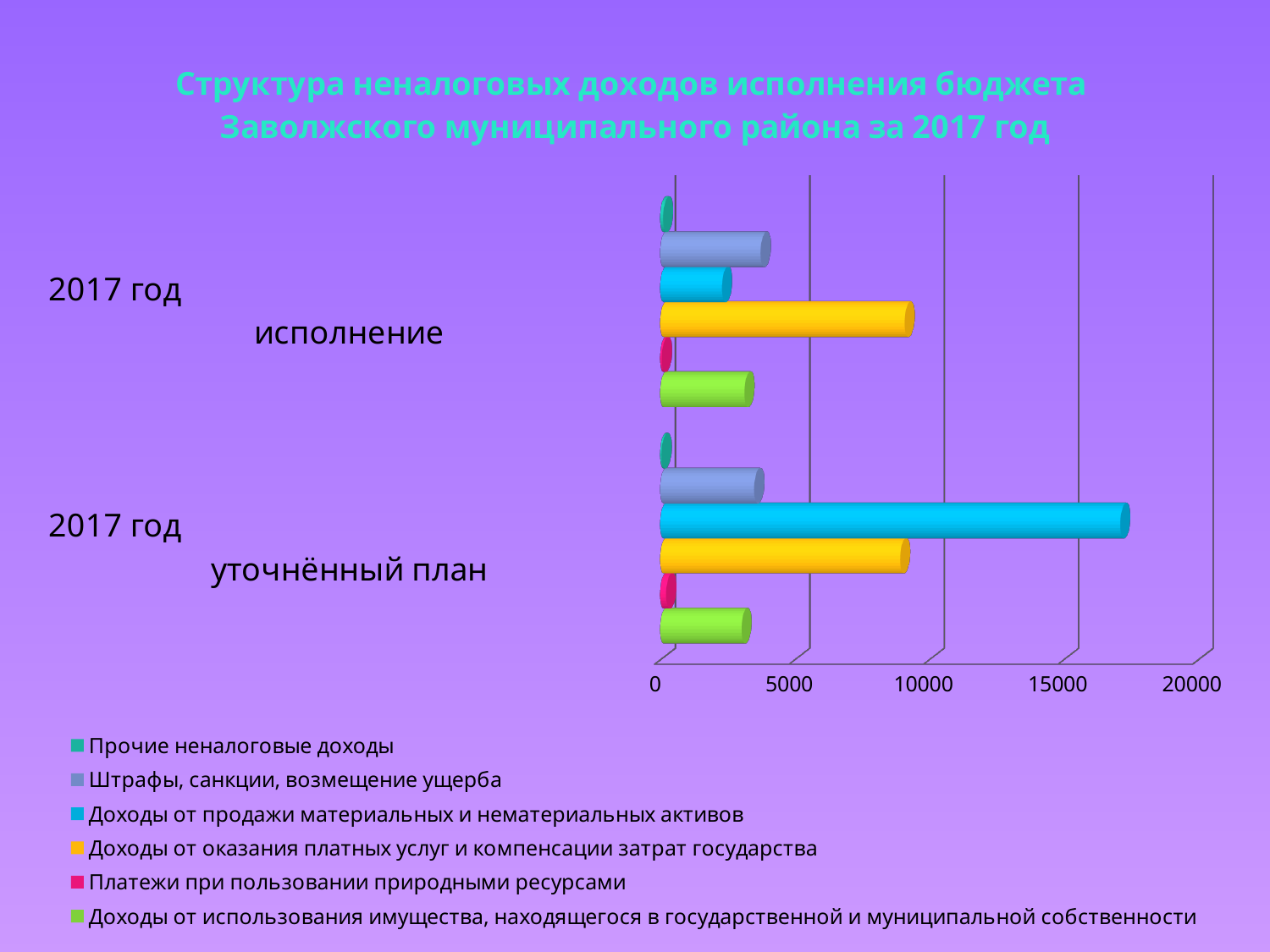
How many categories are shown on the vertical axis of the chart? 2 For Доходы от продажи материальных и нематериальных активов, which is larger: 2017 год уточнённый план or 2017 год исполнение? 2017 год уточнённый план Is the value for Доходы от продажи материальных и нематериальных активов in 2017 год уточнённый план greater or less than 15000? greater What is the title of the chart? Структура неналоговых доходов исполнения бюджета Заволжского муниципального района за 2017 год Which series is shown in yellow in the legend? Доходы от оказания платных услуг и компенсации затрат государства Is the value for Доходы от оказания платных услуг и компенсации затрат государства in 2017 год исполнение greater or less than 5000? greater What kind of chart is shown on the slide? bar chart How many series does the legend list? 6 Which series has the highest value in 2017 год исполнение? Доходы от оказания платных услуг и компенсации затрат государства Is the value for Штрафы, санкции, возмещение ущерба in 2017 год уточнённый план greater or less than 5000? less Which series has the highest value in 2017 год уточнённый план? Доходы от продажи материальных и нематериальных активов